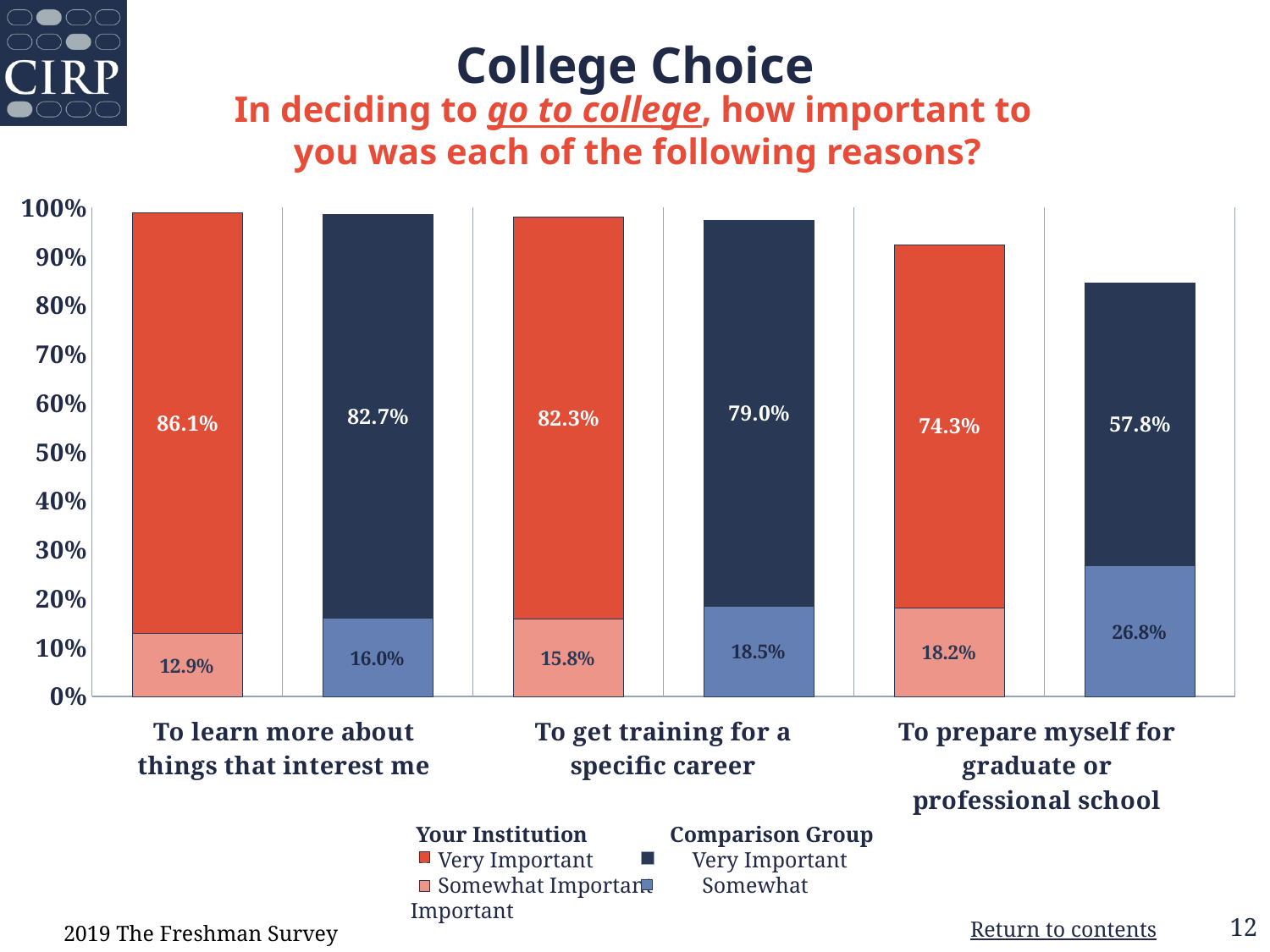
What type of chart is shown on the slide? Stacked bar chart For "To get training for a specific career", which group has the larger Somewhat Important percentage, Your Institution or the Comparison Group? Comparison Group What is the combined Very Important and Somewhat Important total for the Comparison Group bar for "To prepare myself for graduate or professional school"? 84.6% What percentage of the Comparison Group rated "To prepare myself for graduate or professional school" as Somewhat Important? 26.8% Which reason has the highest Very Important percentage for Your Institution? To learn more about things that interest me What percentage of Your Institution students rated "To learn more about things that interest me" as Very Important? 86.1% Which reason has the lowest Very Important percentage for the Comparison Group? To prepare myself for graduate or professional school What percentage of the Comparison Group rated "To get training for a specific career" as Very Important? 79.0% How many series does the legend list? 4 What is the difference between Your Institution and the Comparison Group Very Important percentages for "To prepare myself for graduate or professional school"? 16.5% How many reasons (categories) are shown on the x axis of the chart? 3 What is the combined Very Important and Somewhat Important total for the Your Institution bar for "To learn more about things that interest me"? 99.0%